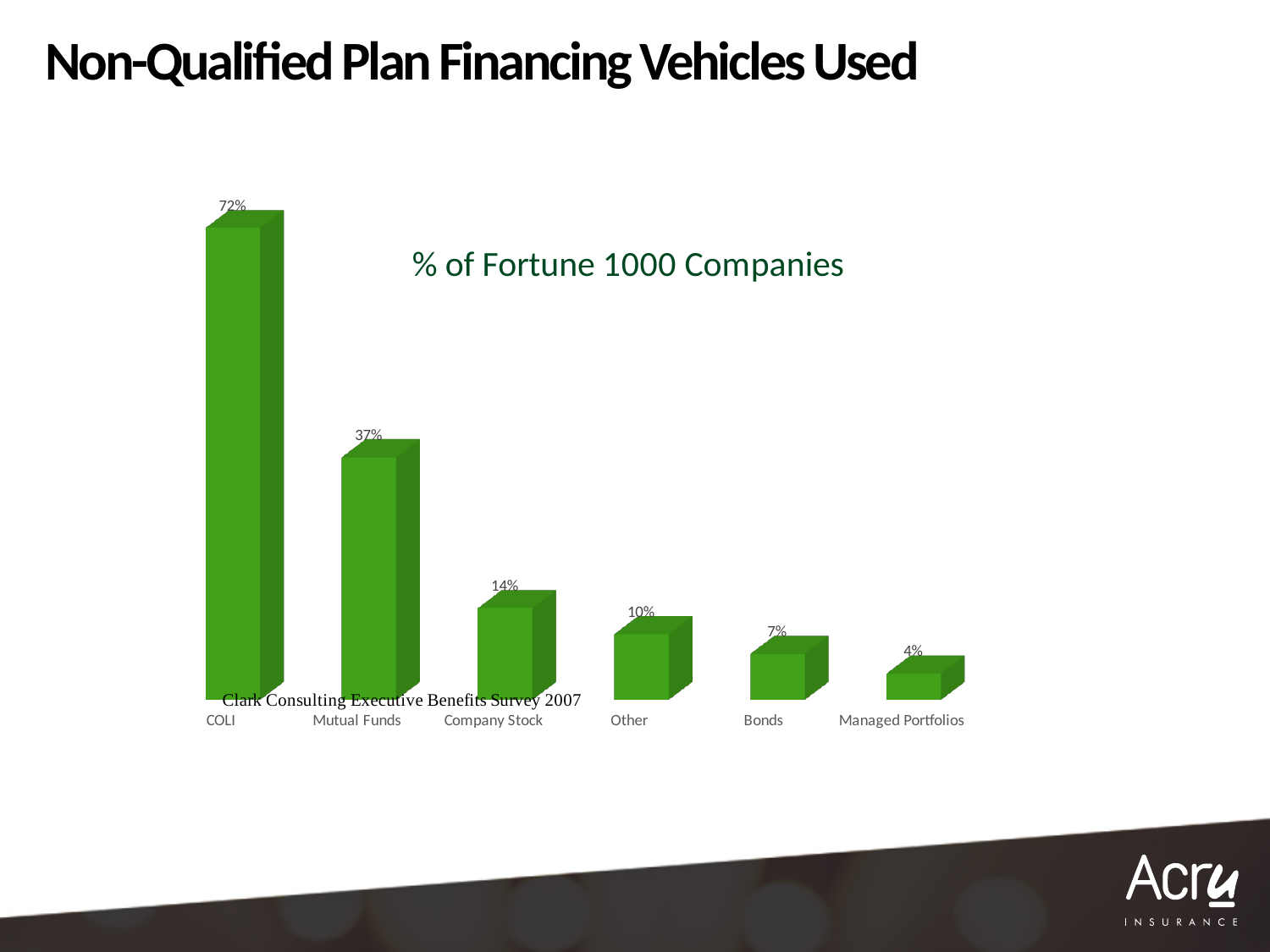
What percentage of Fortune 1000 companies use COLI as a financing vehicle? 72% What is the value shown for Bonds? 7% Which is larger, the value for Company Stock or the value for Bonds? Company Stock Which financing vehicle has the lowest percentage? Managed Portfolios What is the value shown for Mutual Funds? 37% What is the difference between the Other and Managed Portfolios percentages? 6% What is the difference between the COLI and Mutual Funds percentages? 35% What type of chart is shown on the slide? Bar chart Which financing vehicle has the highest percentage? COLI How many financing vehicle categories are shown in the chart? 6 What is the title of the chart? % of Fortune 1000 Companies What is the value shown for Company Stock? 14%